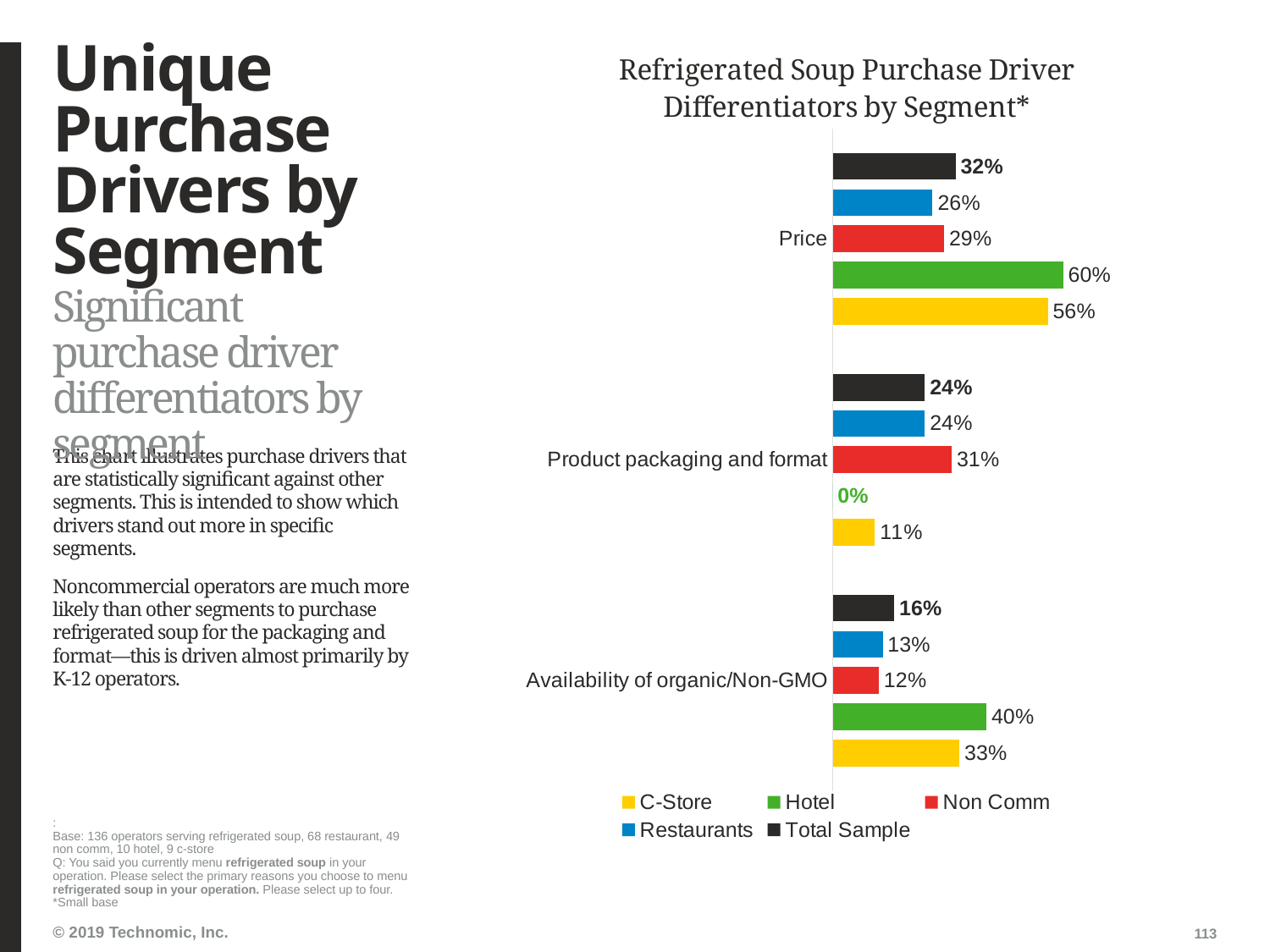
What is the Non Comm value for Product packaging and format? 31% How many series does the legend list? 5 What is the C-Store value for Availability of organic/Non-GMO? 33% What colour represents the Hotel series in the chart? Green Which segment has the lowest value for Product packaging and format? Hotel What is the Total Sample value for Product packaging and format? 24% What is the Hotel value for Price? 60% For Price, is the Non Comm value larger or the Restaurants value? Non Comm What kind of chart is shown on the slide? Bar chart What is the difference between the Hotel and C-Store values for Availability of organic/Non-GMO? 7% Which segment has the highest value for Price? Hotel How many categories (purchase drivers) are shown on the chart? 3